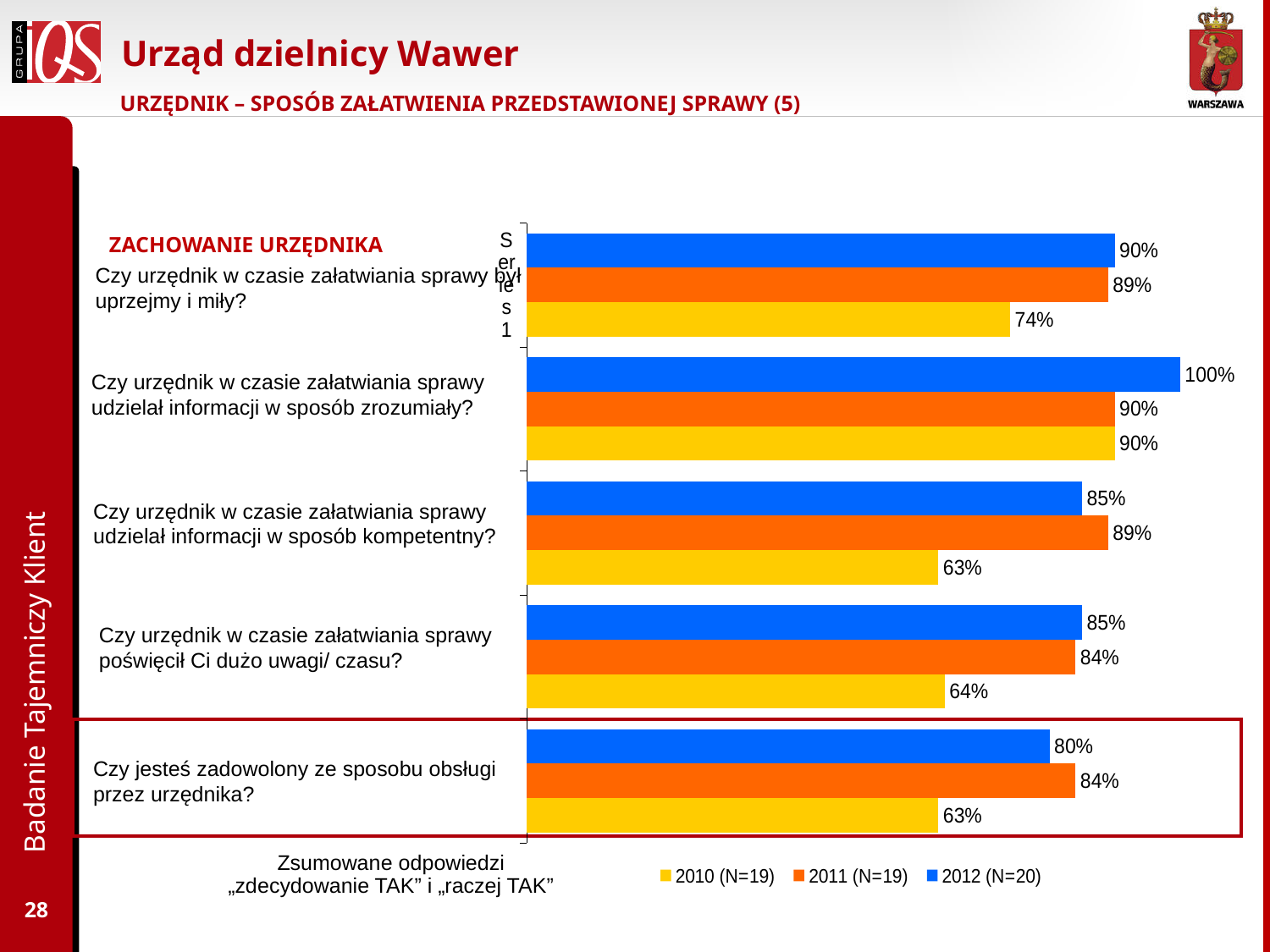
What is the 2012 value for "Czy urzędnik w czasie załatwiania sprawy udzielał informacji w sposób zrozumiały?"? 100% Which question has the lowest 2010 value? Czy urzędnik w czasie załatwiania sprawy udzielał informacji w sposób kompetentny? and Czy jesteś zadowolony ze sposobu obsługi przez urzędnika? (both 63%) What is the difference between the 2012 and 2010 values for "Czy urzędnik w czasie załatwiania sprawy udzielał informacji w sposób kompetentny?"? 22 percentage points What is the 2010 value for "Czy jesteś zadowolony ze sposobu obsługi przez urzędnika?"? 63% Which question has the highest 2012 value? Czy urzędnik w czasie załatwiania sprawy udzielał informacji w sposób zrozumiały? What kind of chart is shown on the slide? Bar chart What sample size (N) is given for 2012 in the legend? N=20 How many series does the legend list? 3 For "Czy jesteś zadowolony ze sposobu obsługi przez urzędnika?", which year has the larger value, 2011 or 2012? 2011 What is the 2011 value for "Czy urzędnik w czasie załatwiania sprawy poświęcił Ci dużo uwagi/ czasu?"? 84% What is the 2010 value for "Czy urzędnik w czasie załatwiania sprawy był uprzejmy i miły?"? 74% How many questions (categories) are shown in the chart? 5